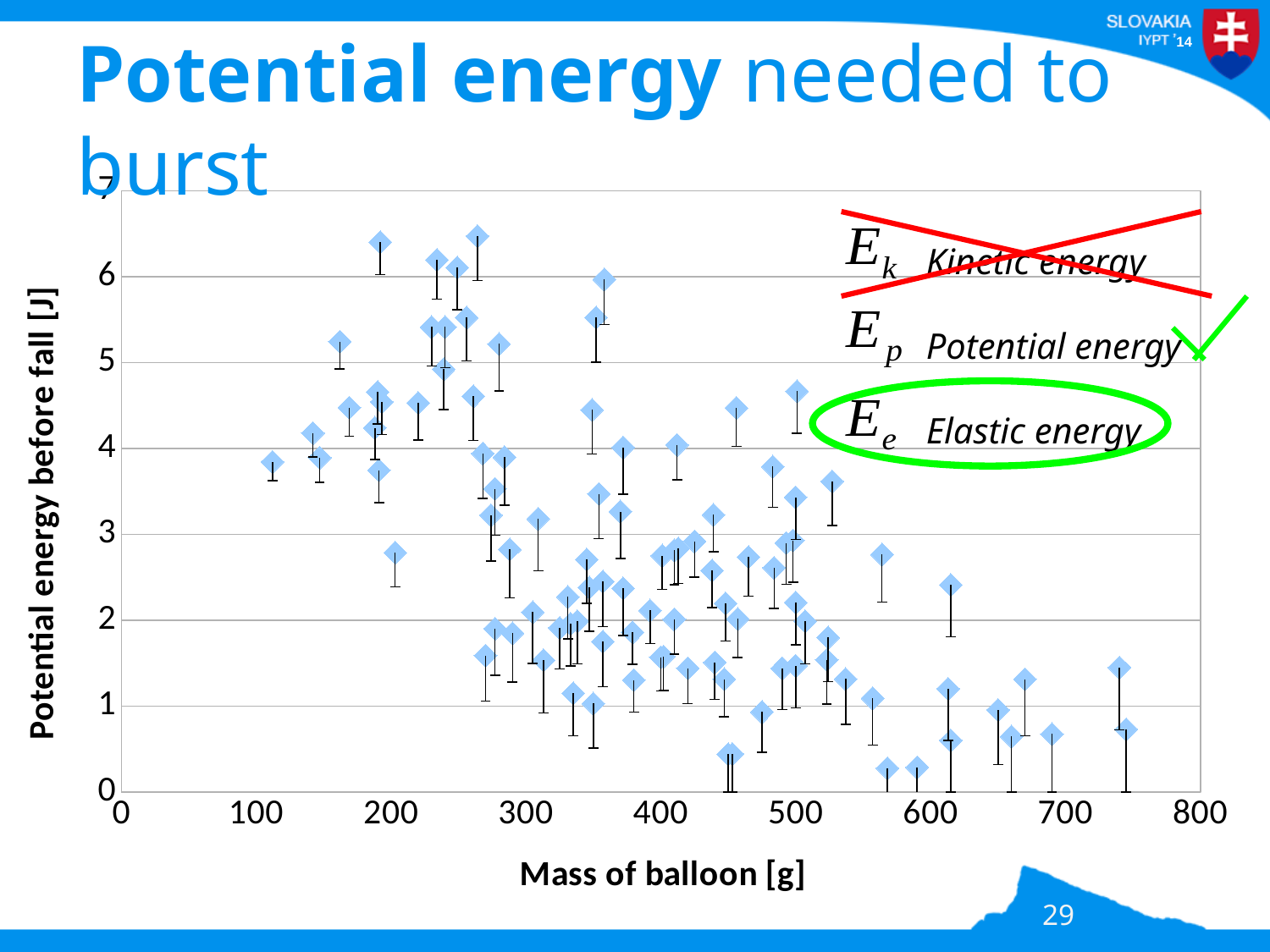
What is the title of the vertical axis of the chart? Potential energy before fall [J] Which is larger: the highest potential energy plotted for balloons around 200 g, or the highest plotted for balloons around 700 g? around 200 g Is the lowest plotted potential energy value greater or less than 1 J? less What is the title of the horizontal axis of the chart? Mass of balloon [g] What kind of chart is shown on the slide? scatter chart Are any plotted points above 7 J on the chart? No As the mass of the balloon increases along the x axis, do the plotted potential energy values generally rise or fall? fall Is the potential energy of the point with the smallest balloon mass (around 110 g) greater or less than 3 J? greater